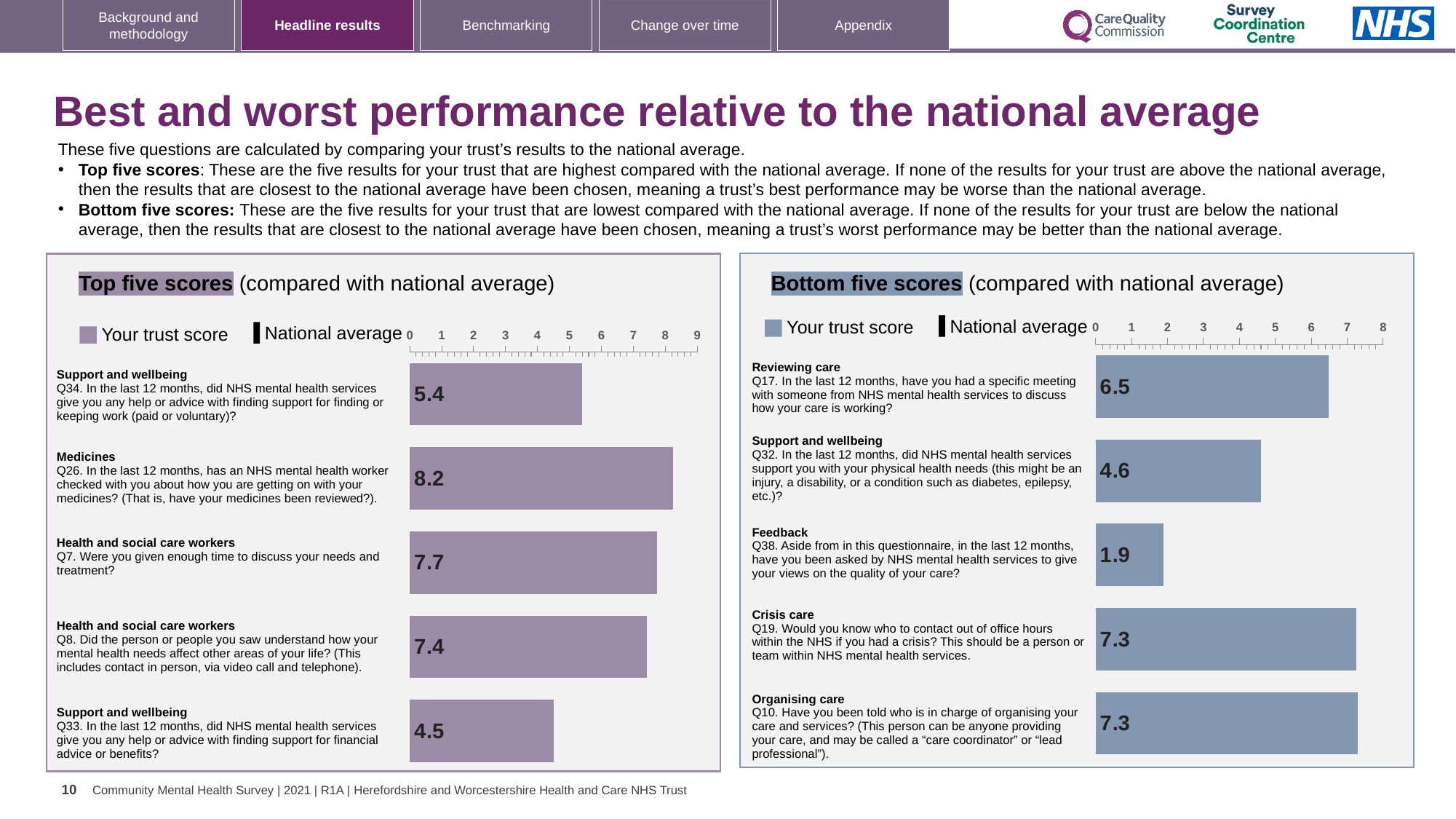
In the Top five scores chart, what is the difference between the trust scores for Q7 and Q8? 0.3 In the Top five scores chart, how many questions are plotted? 5 In the Top five scores chart, what is the trust score for Q26 (Medicines)? 8.2 What type of chart is used in the Bottom five scores panel? Bar chart In the Bottom five scores chart, what is the trust score for Q17 (Reviewing care)? 6.5 In the Top five scores chart, which question has the highest trust score? Q26 (Medicines) In the Bottom five scores chart, is the trust score for Q32 larger or smaller than the score for Q17? smaller In the Bottom five scores chart, which question has the lowest trust score? Q38 (Feedback) In the Top five scores chart, which question has the lowest trust score? Q33 (Support and wellbeing) In the Top five scores chart, what is the trust score for Q33 (Support and wellbeing, financial advice or benefits)? 4.5 In the Bottom five scores chart, what is the trust score for Q38 (Feedback)? 1.9 In the Bottom five scores chart, what is the difference between the trust scores for Q19 and Q38? 5.4